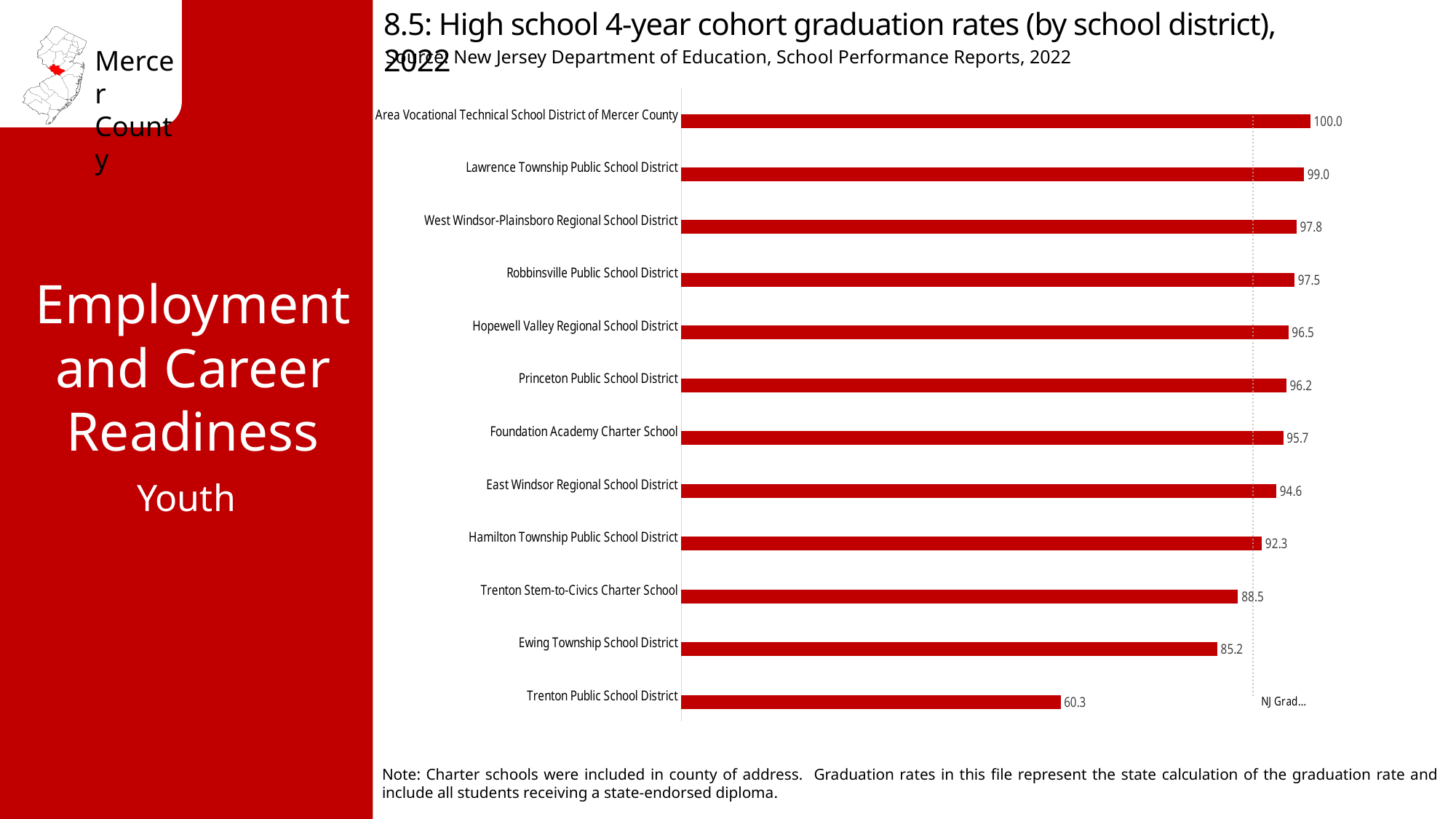
What is the graduation rate for Lawrence Township Public School District? 99.0 What is the graduation rate for Trenton Stem-to-Civics Charter School? 88.5 Which school district has the highest graduation rate? Area Vocational Technical School District of Mercer County What is the difference in graduation rate between Area Vocational Technical School District of Mercer County and Lawrence Township Public School District? 1.0 Which has a higher graduation rate, Princeton Public School District or East Windsor Regional School District? Princeton Public School District What is the graduation rate for Trenton Public School District? 60.3 What is the difference in graduation rate between Ewing Township School District and Trenton Public School District? 24.9 What is the graduation rate for Hamilton Township Public School District? 92.3 How many school districts are shown in the chart? 12 Which school district has the lowest graduation rate? Trenton Public School District What kind of chart is shown on the slide? Bar chart What is the source cited for the chart data? New Jersey Department of Education, School Performance Reports, 2022